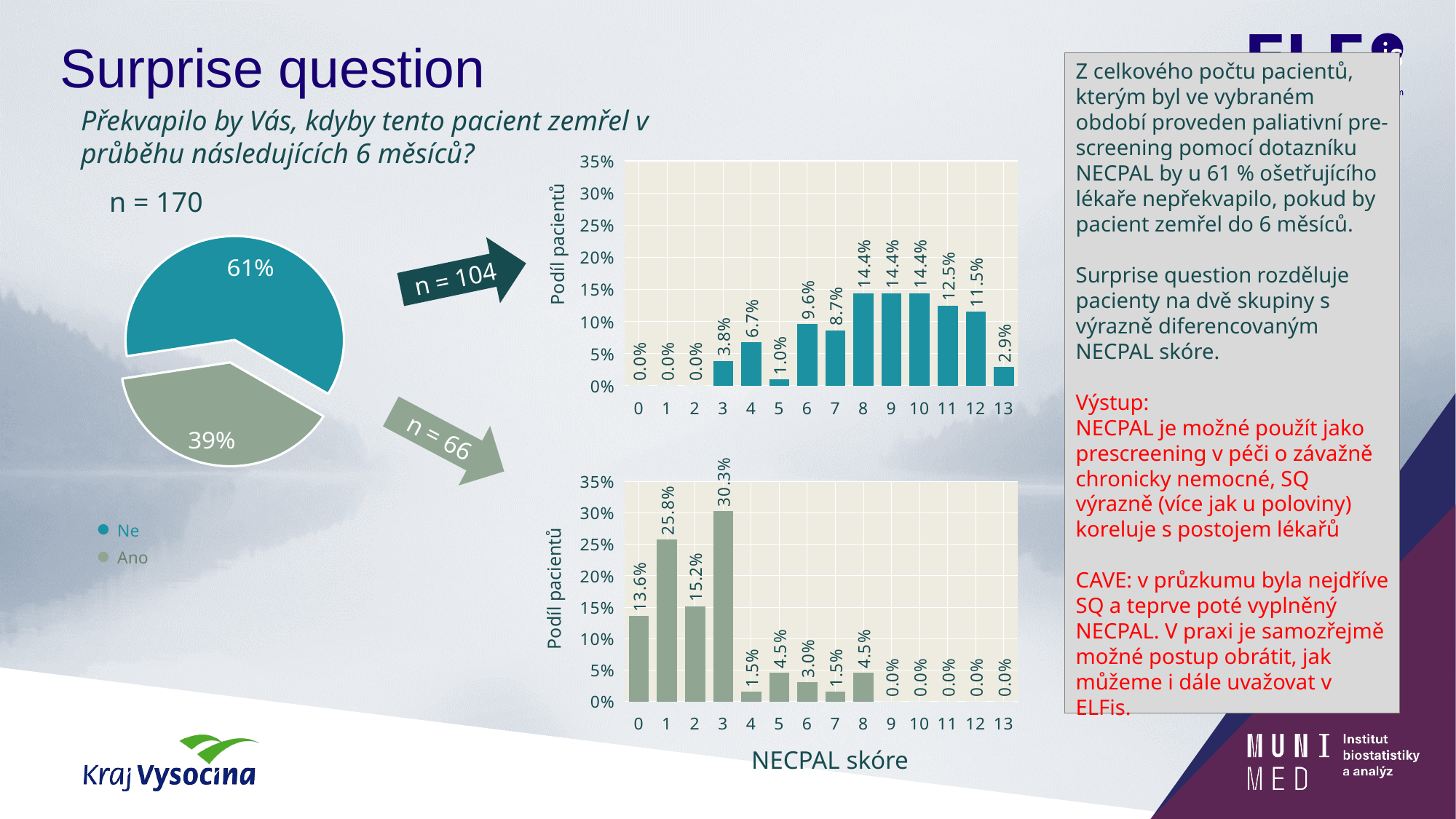
In the bottom bar chart, which NECPAL score has the highest value? 3 What kind of chart is the chart on the left of the slide? pie chart In the pie chart on the left, what share of patients answered "Ano"? 39% In the bottom bar chart, which is larger, the value for NECPAL score 0 or NECPAL score 2? NECPAL score 2 What kind of chart is the top chart in the middle of the slide? bar chart What is the x-axis label shared by the two bar charts? NECPAL skóre In the top bar chart, what is the value for NECPAL score 13? 2.9% In the top bar chart, what is the value for NECPAL score 8? 14.4% In the top bar chart, what is the difference between the values for NECPAL score 11 and NECPAL score 12? 1.0% In the bottom bar chart, how many NECPAL score categories are shown on the x axis? 14 In the bottom bar chart, what is the value for NECPAL score 1? 25.8% In the pie chart on the left, what share of patients answered "Ne"? 61%